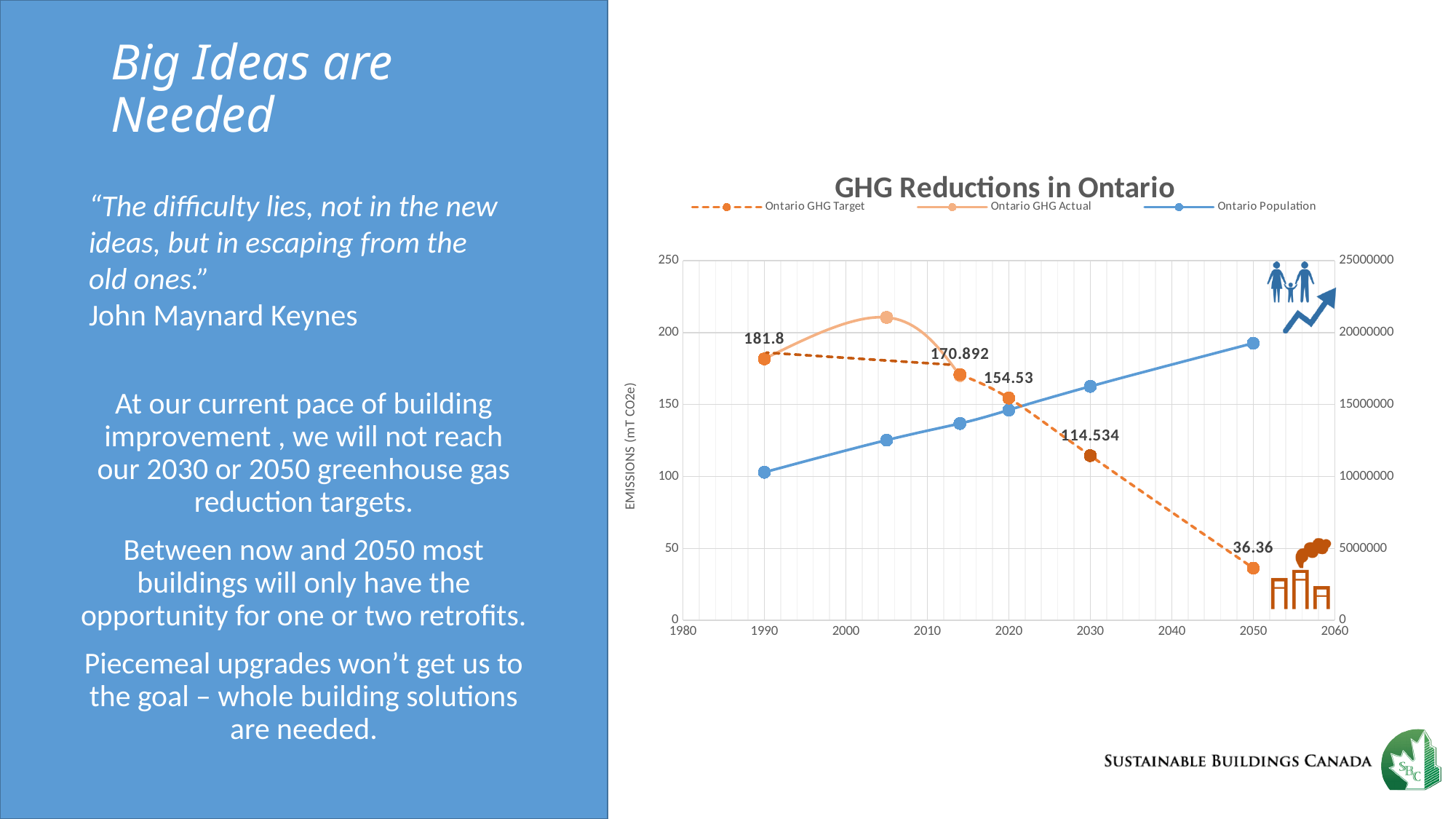
What is the difference between the Ontario GHG Target values for 1990 and 2050? 145.44 How many series does the chart legend list? 3 What is the Ontario GHG Target value for 2030? 114.534 What is the Ontario GHG Target value for 2020? 154.53 What is the title of the chart? GHG Reductions in Ontario Which year has the lowest labelled Ontario GHG Target value? 2050 What kind of chart is shown on the slide? line chart What is the Ontario GHG Target value for 2050? 36.36 What is the Ontario GHG Target value for 1990? 181.8 How many data labels are printed on the Ontario GHG Target series? 5 Does the Ontario GHG Target series rise or fall from 1990 to 2050? fall Is the peak value of the Ontario GHG Actual series (around 2005) greater or less than 200? greater